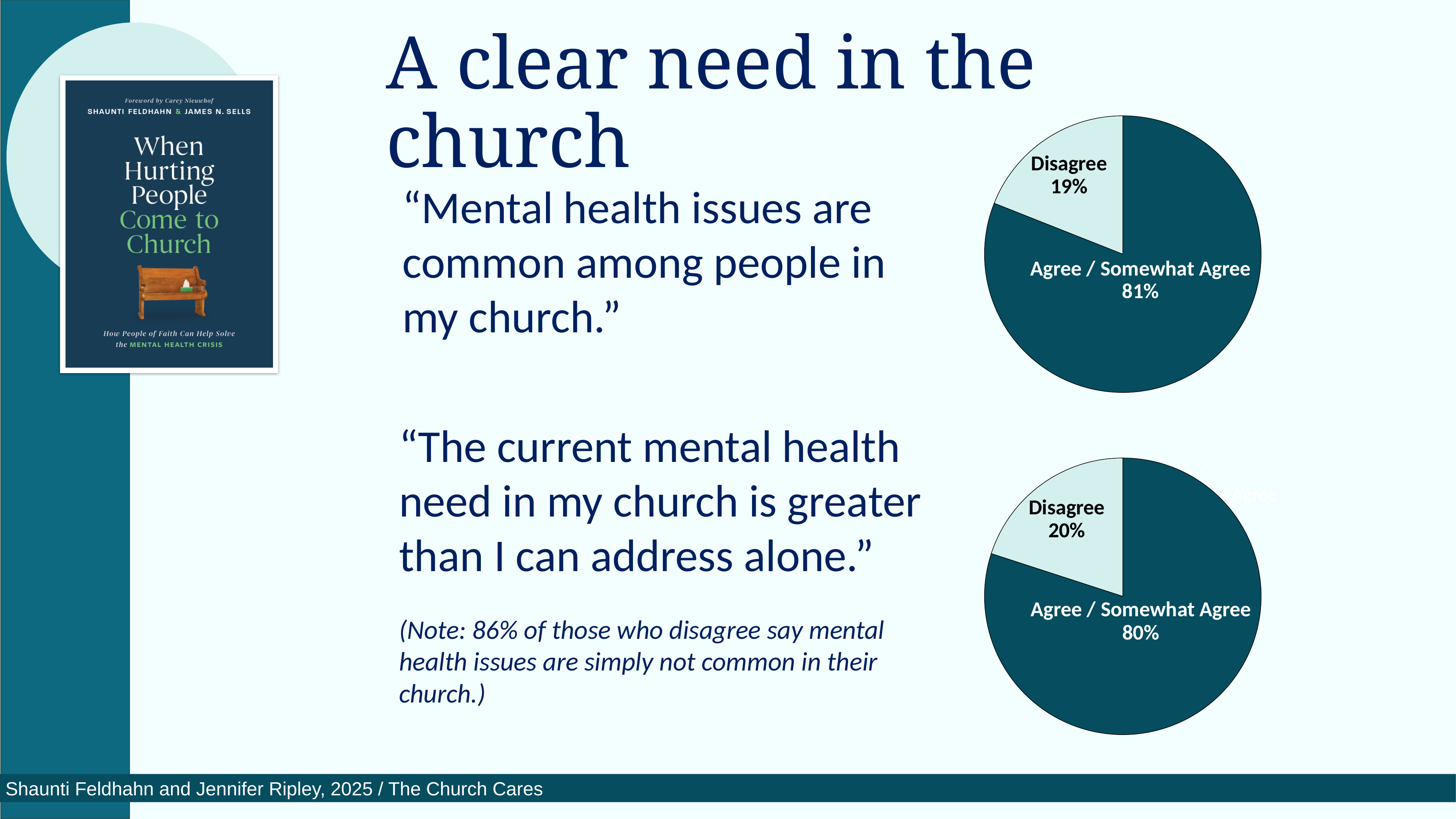
What kind of chart is the bottom chart on the slide? Pie chart In the top pie chart, which slice is the largest? Agree / Somewhat Agree How many slices does the top pie chart have? 2 In the bottom pie chart, what percentage is labelled Agree / Somewhat Agree? 80% In the top pie chart, what percentage is labelled Disagree? 19% In the bottom pie chart, which slice is the smallest? Disagree In the bottom pie chart, what is the difference between the Agree / Somewhat Agree share and the Disagree share? 60% In the top pie chart, what is the difference between the Agree / Somewhat Agree share and the Disagree share? 62% In the top pie chart, what colour is the Disagree slice? Light blue In the bottom pie chart, what percentage is labelled Disagree? 20% Which is larger: the Disagree share in the top pie chart or the Disagree share in the bottom pie chart? Bottom pie chart In the top pie chart, what percentage is labelled Agree / Somewhat Agree? 81%